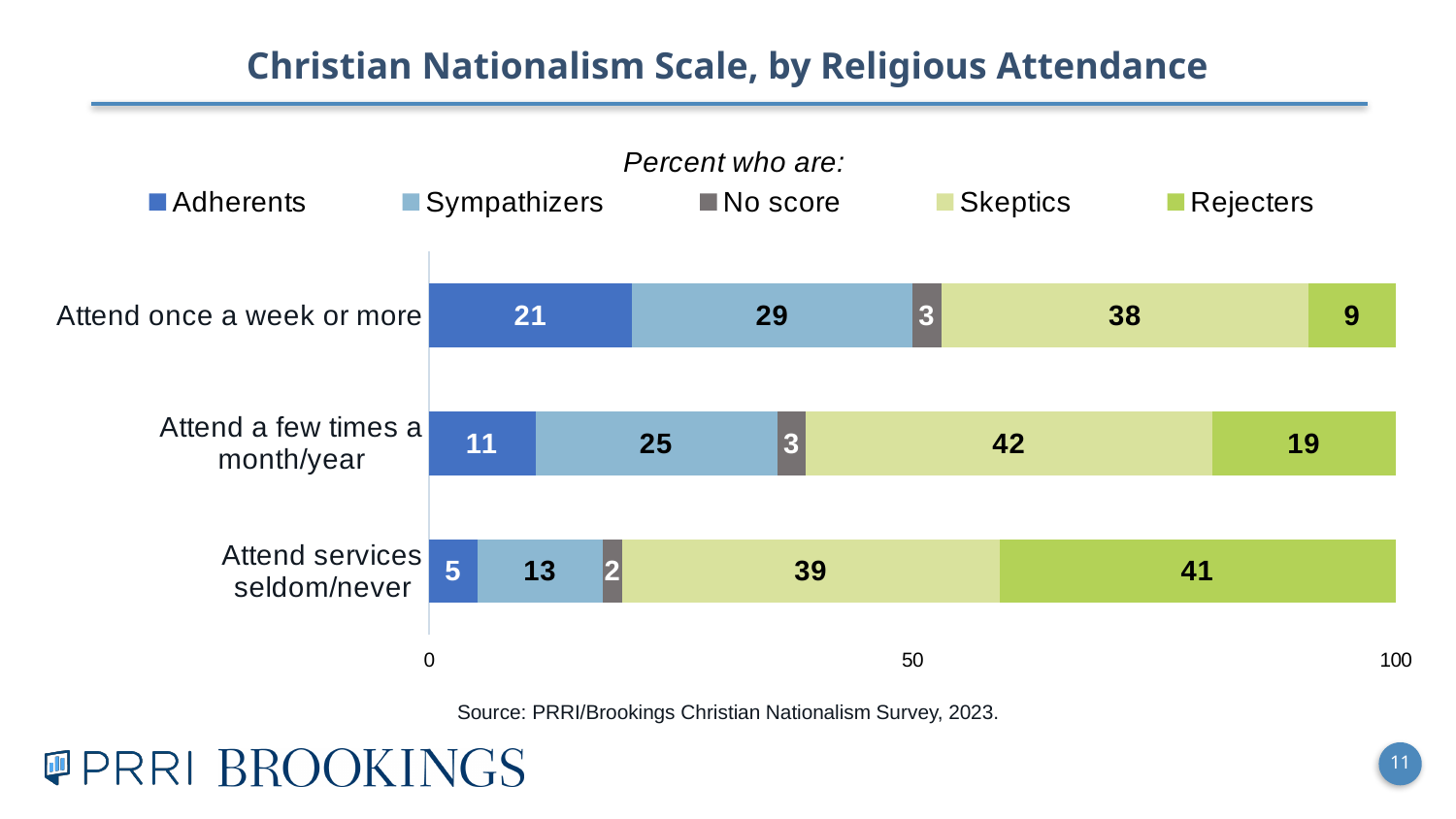
What percent of those who attend once a week or more are Adherents? 21 What percent of those who attend services seldom/never are Rejecters? 41 Which attendance group has the highest percent of Adherents? Attend once a week or more What kind of chart is shown on the slide? Stacked bar chart How many series does the legend list? 5 Which attendance group has the lowest percent of Rejecters? Attend once a week or more What percent of those who attend a few times a month/year are Skeptics? 42 What is the title of the chart? Christian Nationalism Scale, by Religious Attendance How many attendance categories are shown in the chart? 3 What is the total of the stacked bar for those who attend once a week or more? 100 Which is larger: the percent of Rejecters among those who attend a few times a month/year or among those who attend services seldom/never? Attend services seldom/never What is the difference in the percent of Sympathizers between those who attend once a week or more and those who attend services seldom/never? 16